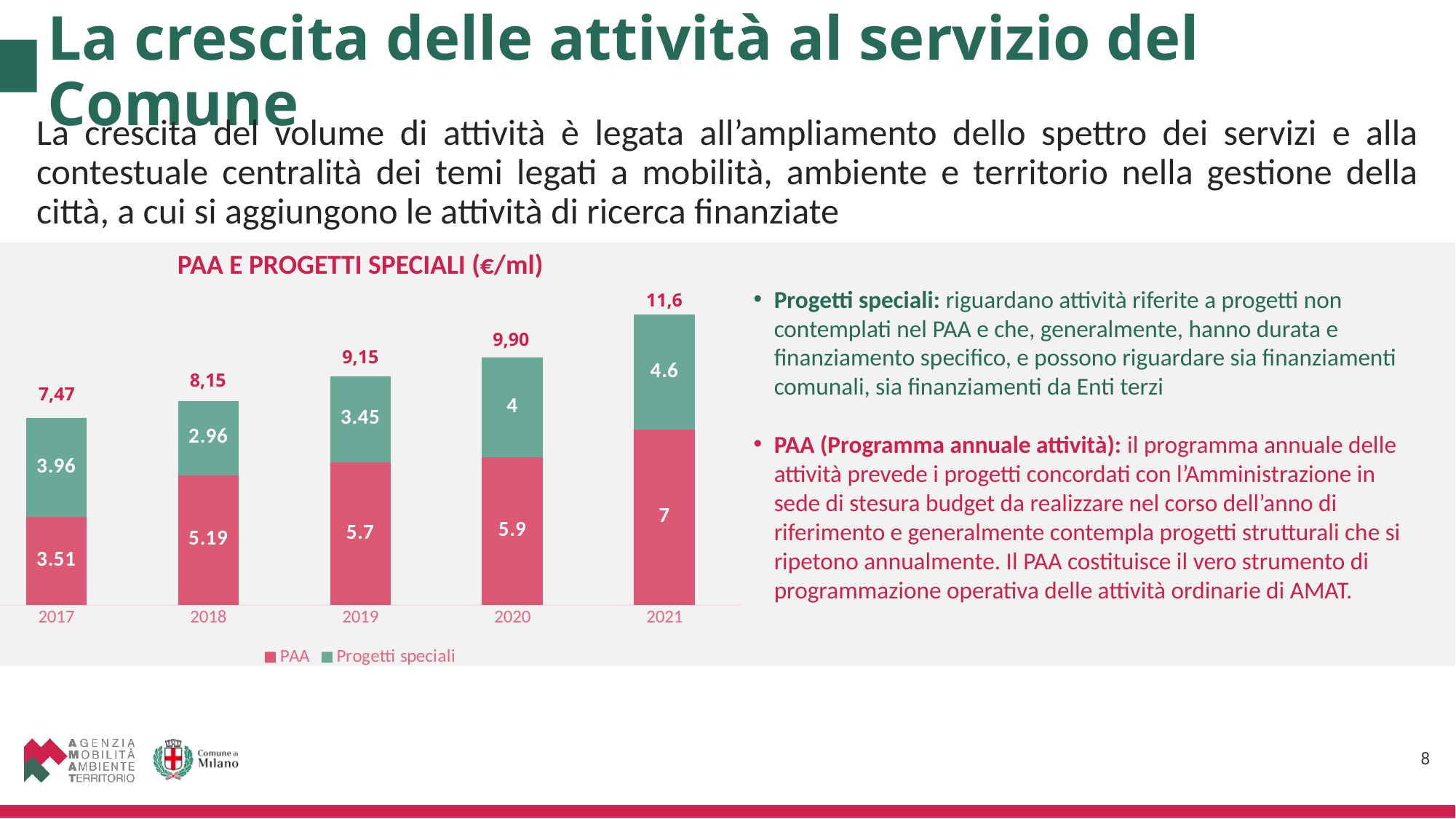
How many series does the legend list? 2 What is the difference between the PAA values for 2021 and 2017? 3.49 What is the total shown above the 2020 bar? 9,90 Which year has the lowest PAA value? 2017 What is the Progetti speciali value for 2021? 4.6 What is the title of the chart? PAA E PROGETTI SPECIALI (€/ml) Which year has the highest total? 2021 What is the PAA value for 2019? 5.7 Which is larger, the Progetti speciali value for 2018 or for 2020? 2020 What kind of chart is shown? stacked bar chart Do the totals rise or fall from 2017 to 2021? rise How many years are shown on the x axis? 5